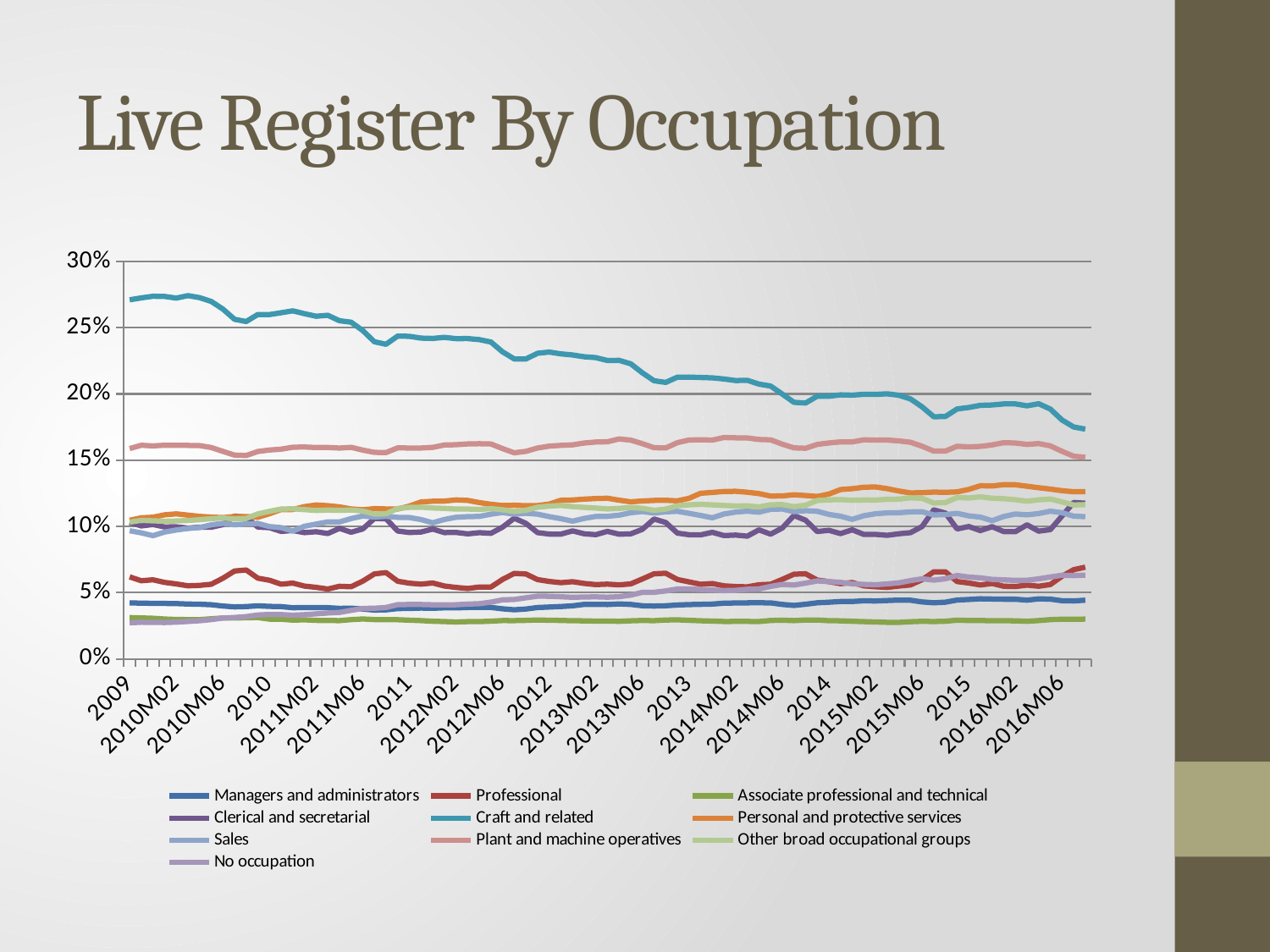
Is the value for Managers and administrators at 2009 greater or less than 5%? less What is the title of the chart? Live Register By Occupation Is the value for Craft and related at 2009 greater or less than 25%? greater How many series does the legend list? 10 Does the Personal and protective services series rise or fall from 2009 to 2016M06? rise Is the value for Craft and related at 2016M06 greater or less than 20%? less Which occupation series has the lowest values across most of the period? Associate professional and technical Which occupation series has the highest values across the whole period? Craft and related At 2009, which is larger: Professional or Associate professional and technical? Professional At 2009, which is larger: Craft and related or Plant and machine operatives? Craft and related Does the Craft and related series rise or fall from 2009 to 2016M06? fall What kind of chart is shown on the slide? line chart